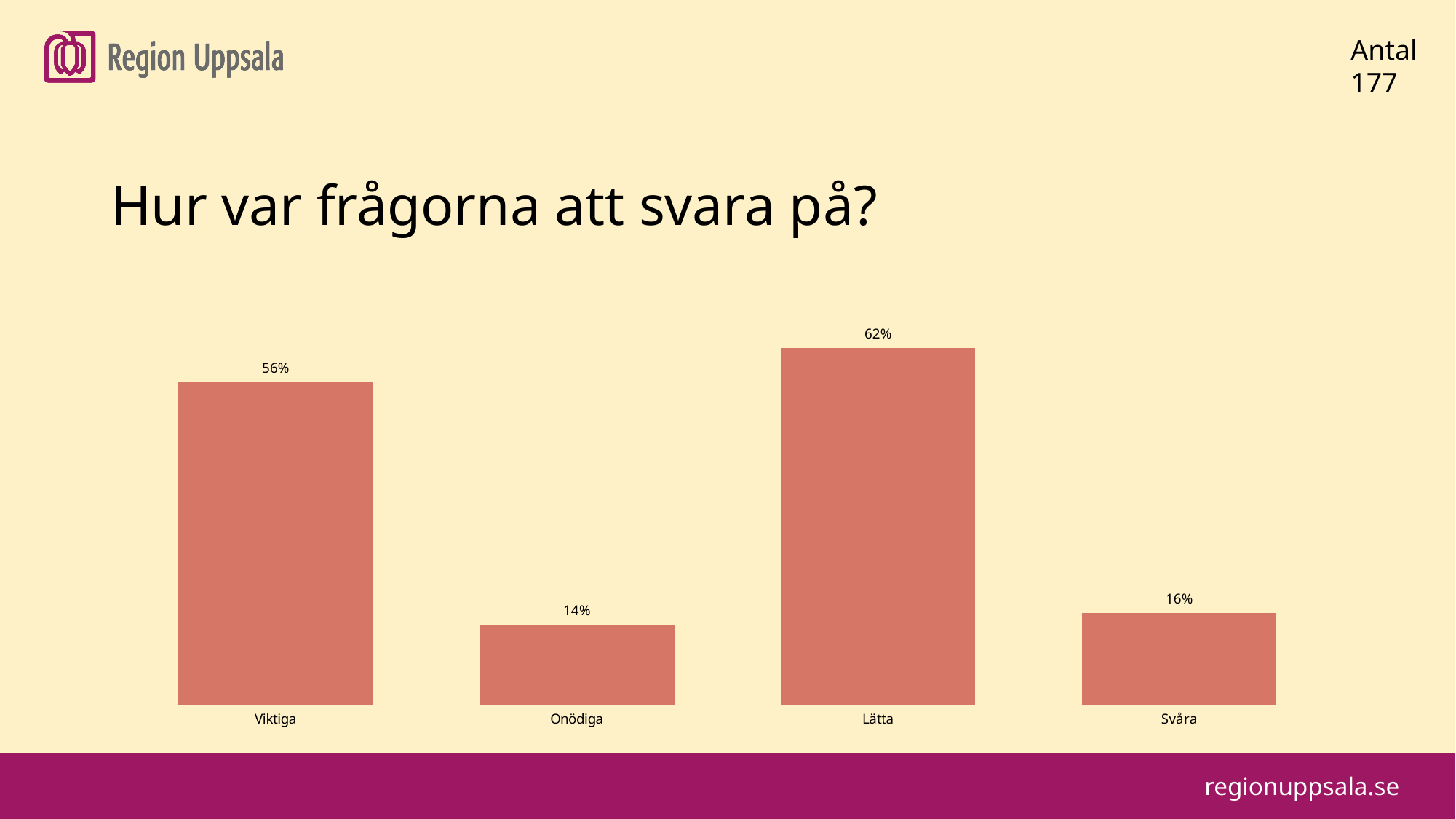
Which category has the lowest value? Onödiga What is the value for Lätta? 62% Which is larger, the value for Viktiga or the value for Svåra? Viktiga What is the value for Svåra? 16% What is the title of the slide above the chart? Hur var frågorna att svara på? How many categories are shown in the chart? 4 Which category has the highest value? Lätta What is the difference between the values for Svåra and Onödiga? 2% What is the difference between the values for Lätta and Viktiga? 6% What is the value for Onödiga? 14% What kind of chart is shown on the slide? Bar chart What is the value for Viktiga? 56%